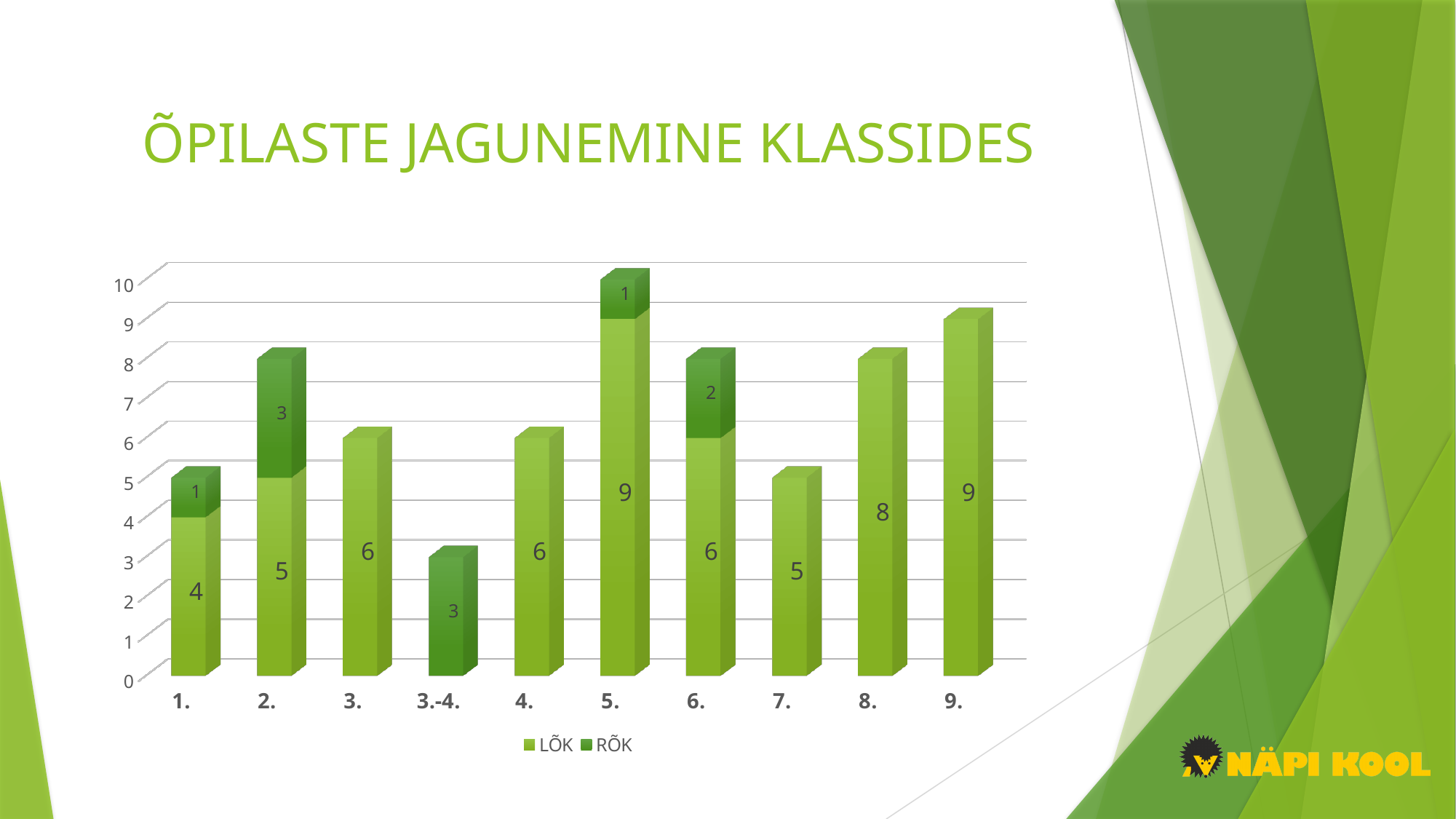
What is the total of the stacked bar for class 2.? 8 Which class has the highest total stacked bar? 5. How many series does the legend list? 2 What is the difference between the LÕK values for class 9. and class 7.? 4 What is the LÕK value for class 1.? 4 How many categories are shown on the x axis? 10 What is the RÕK value for class 2.? 3 What is the RÕK value for class 6.? 2 Which class has the lowest total stacked bar? 3.-4. Which is larger, the LÕK value for class 3. or the LÕK value for class 1.? class 3. What is the LÕK value for class 8.? 8 What is the total of the stacked bar for class 5.? 10